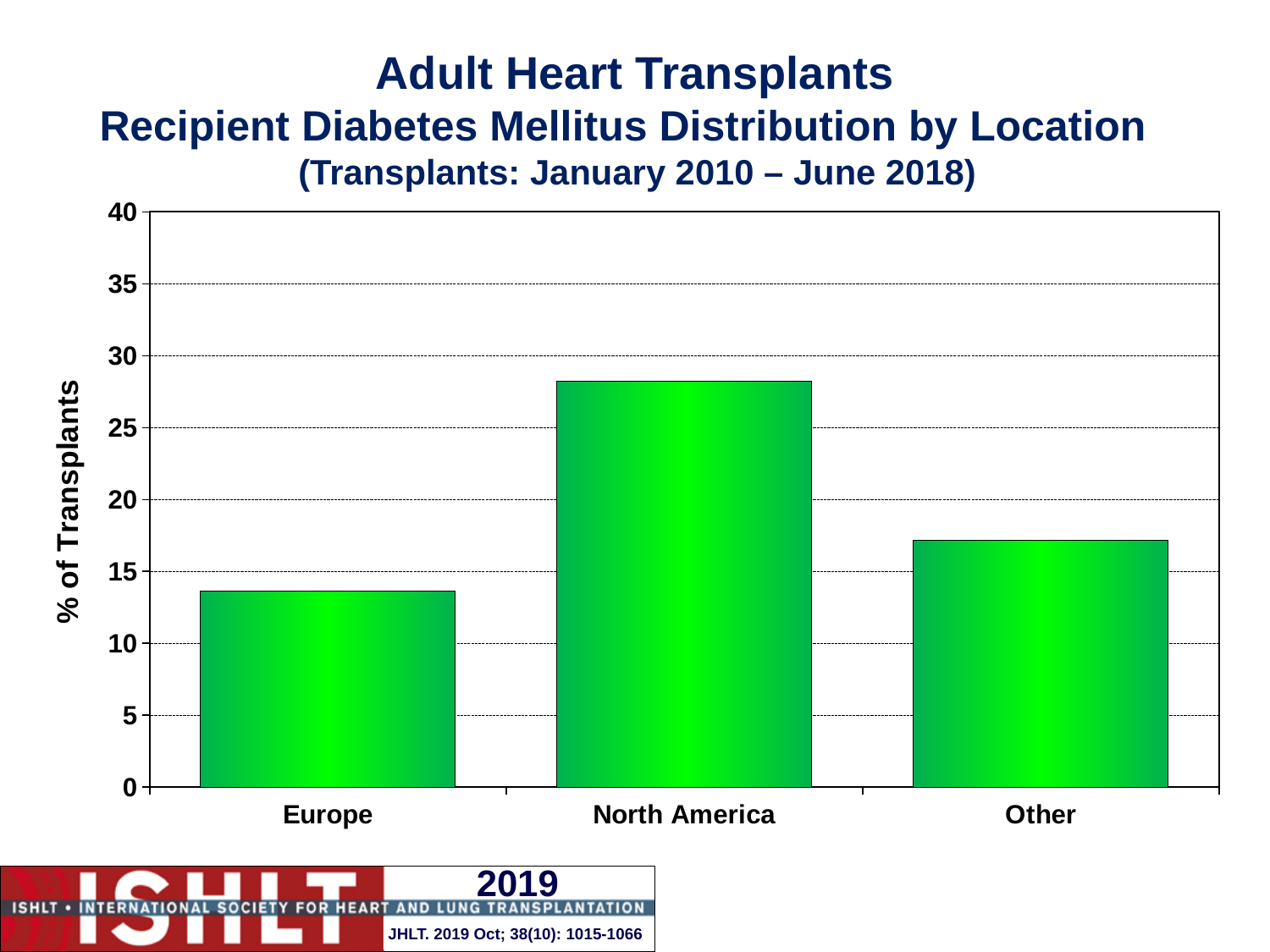
Which is larger, the value for Other or the value for Europe? Other Which location has the highest percentage of transplants with recipient diabetes mellitus? North America What transplant date range is given in the chart title? January 2010 – June 2018 What kind of chart is shown on the slide? bar chart Is the value for Europe greater or less than 15? less What is the label of the y axis? % of Transplants Is the value for North America greater or less than 30? less Is the value for North America greater or less than 25? greater Which location has the lowest percentage of transplants with recipient diabetes mellitus? Europe How many location categories are plotted on the x axis? 3 Which is larger, the value for North America or the value for Other? North America